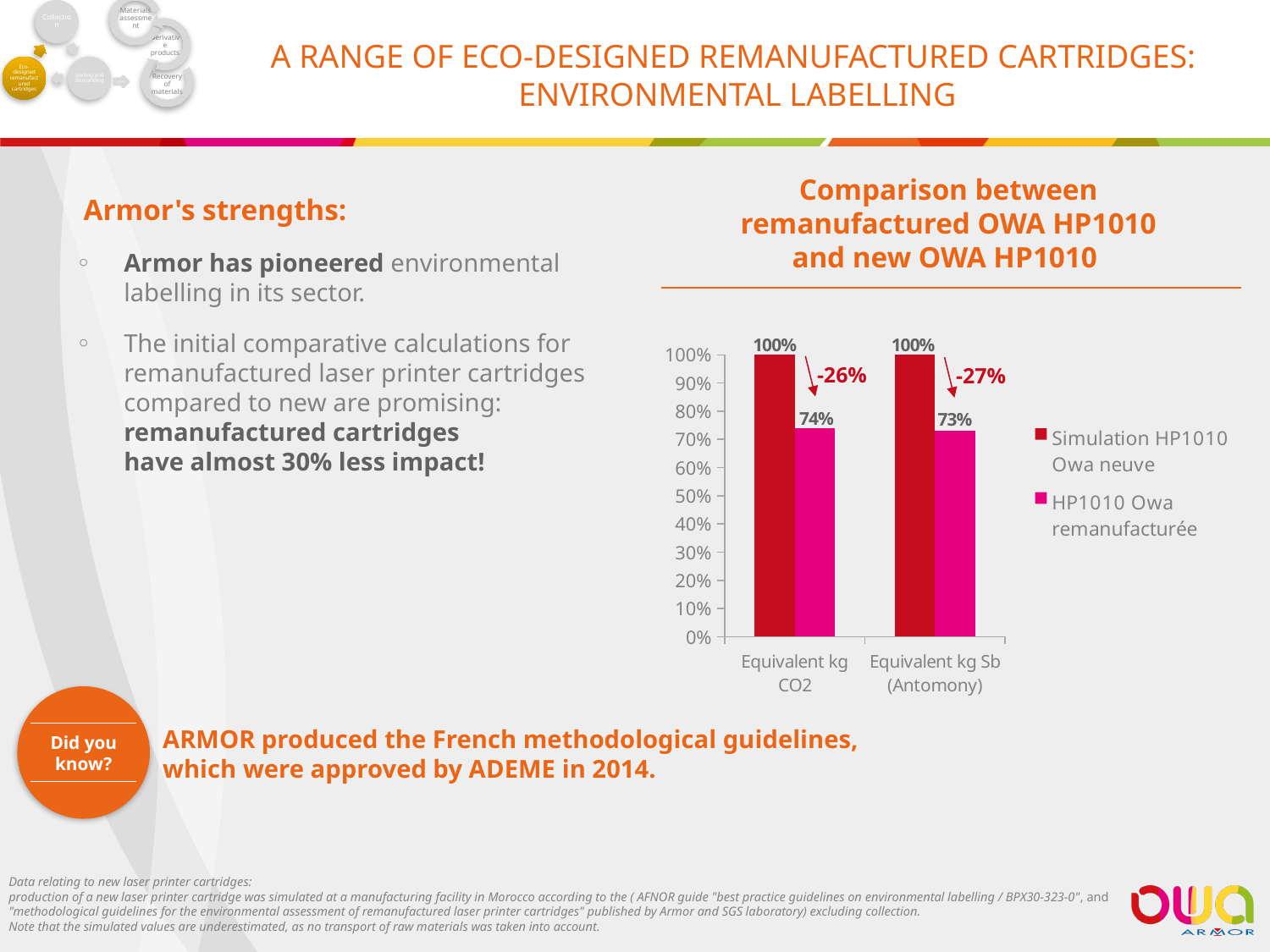
What is the title of the chart? Comparison between remanufactured OWA HP1010 and new OWA HP1010 How many series does the chart legend list? 2 Which series has the larger value in the Equivalent kg Sb (Antomony) category? Simulation HP1010 Owa neuve Is the value for HP1010 Owa remanufacturée in the Equivalent kg CO2 category greater or less than 80%? less What is the value for HP1010 Owa remanufacturée in the Equivalent kg CO2 category? 74% What is the value for Simulation HP1010 Owa neuve in the Equivalent kg CO2 category? 100% What is the difference between the Simulation HP1010 Owa neuve and HP1010 Owa remanufacturée values in the Equivalent kg Sb (Antomony) category? 27% Which category has the lowest value for HP1010 Owa remanufacturée? Equivalent kg Sb (Antomony) What is the value for HP1010 Owa remanufacturée in the Equivalent kg Sb (Antomony) category? 73% What kind of chart is shown on the slide? bar chart What is the difference between the Simulation HP1010 Owa neuve and HP1010 Owa remanufacturée values in the Equivalent kg CO2 category? 26% How many categories are shown on the x axis of the chart? 2